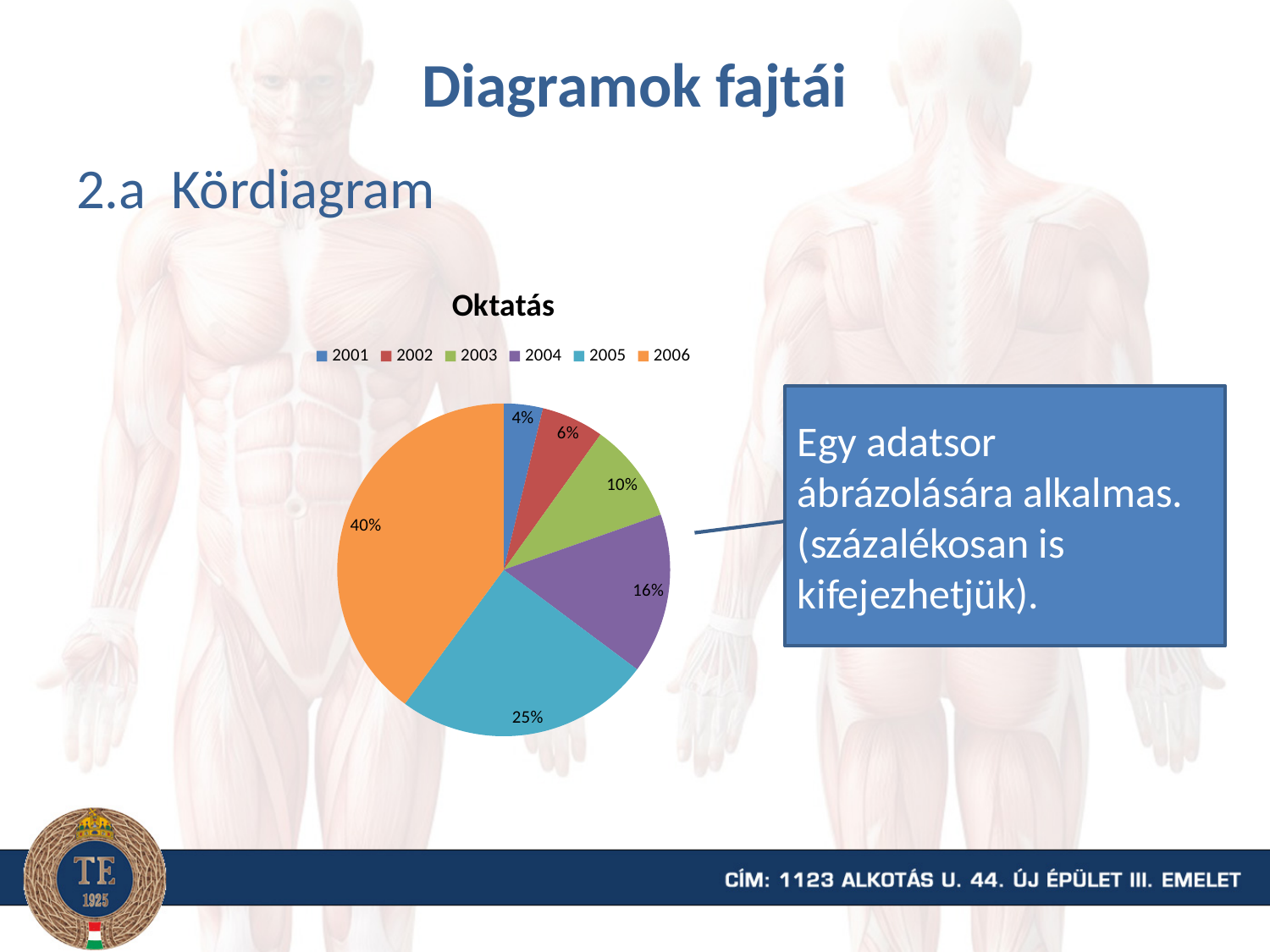
Which year has the largest slice of the pie? 2006 What is the title of the chart? Oktatás Do the slice values increase or decrease from 2001 to 2006? increase How many series does the legend list? 6 What kind of chart is shown on the slide? pie chart What share of the pie does 2001 have? 4% What is the value for 2003? 10% Which is larger, the slice for 2004 or the slice for 2003? 2004 Which year has the smallest slice of the pie? 2001 What is the difference between the shares of 2005 and 2002? 19% What is the value for 2004? 16% What share of the pie does 2006 have? 40%